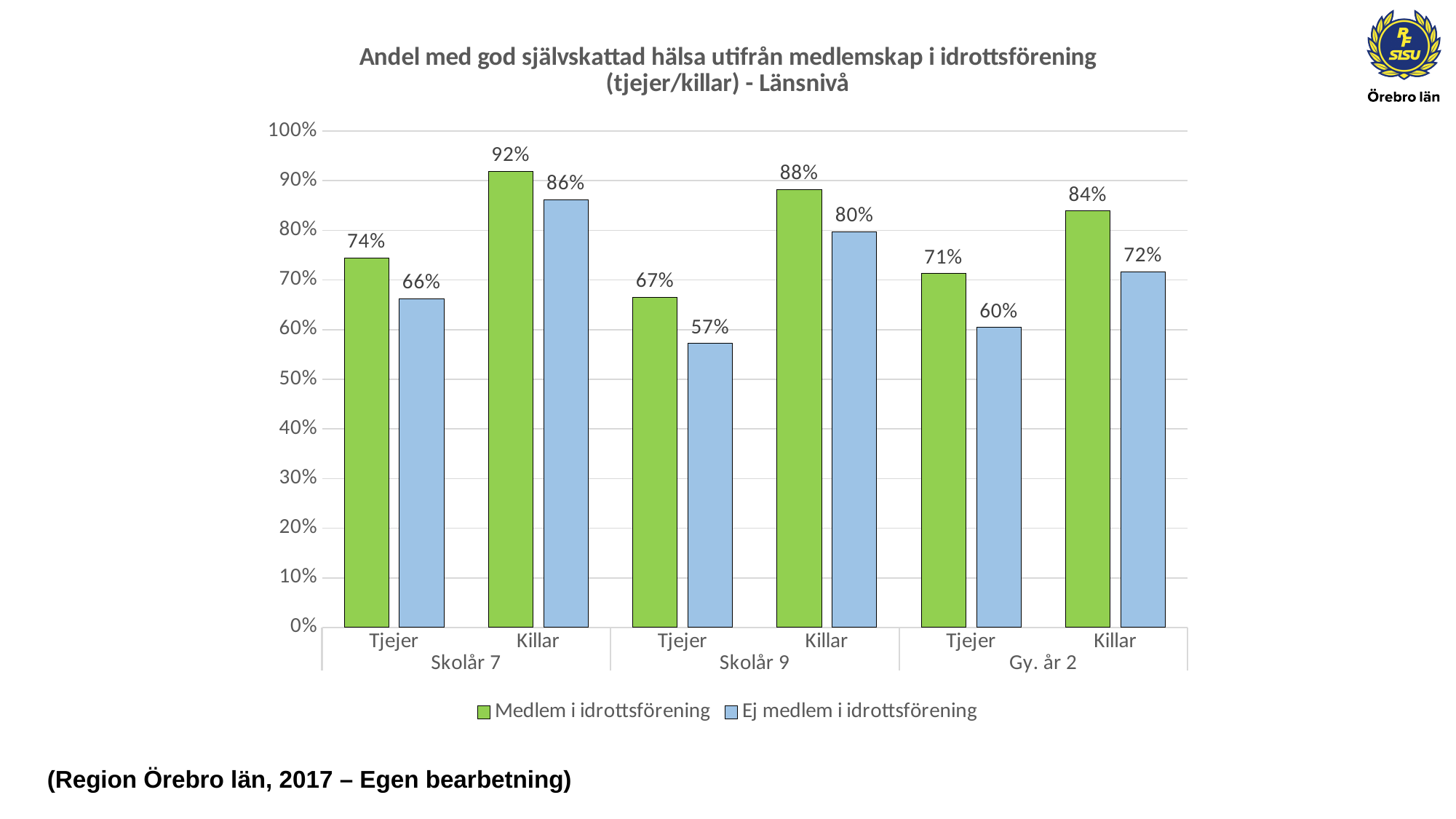
Which group has the lowest value for 'Ej medlem i idrottsförening'? Tjejer, Skolår 9 Which group has the highest value for 'Medlem i idrottsförening'? Killar, Skolår 7 Which is larger: 'Ej medlem i idrottsförening' for Killar in Skolår 7 or 'Medlem i idrottsförening' for Killar in Gy. år 2? Ej medlem i idrottsförening for Killar in Skolår 7 What is the value for 'Ej medlem i idrottsförening' for Tjejer in Gy. år 2? 60% What is the value for 'Medlem i idrottsförening' for Tjejer in Skolår 7? 74% How many series does the legend list? 2 How many school-year groups are shown on the x axis? 3 What colour are the bars for 'Medlem i idrottsförening'? Green What is the value for 'Ej medlem i idrottsförening' for Killar in Skolår 9? 80% What kind of chart is shown on the slide? Bar chart What is the difference between 'Medlem i idrottsförening' and 'Ej medlem i idrottsförening' for Tjejer in Skolår 9? 10% What is the difference between 'Medlem i idrottsförening' for Killar in Skolår 7 and Killar in Gy. år 2? 8%